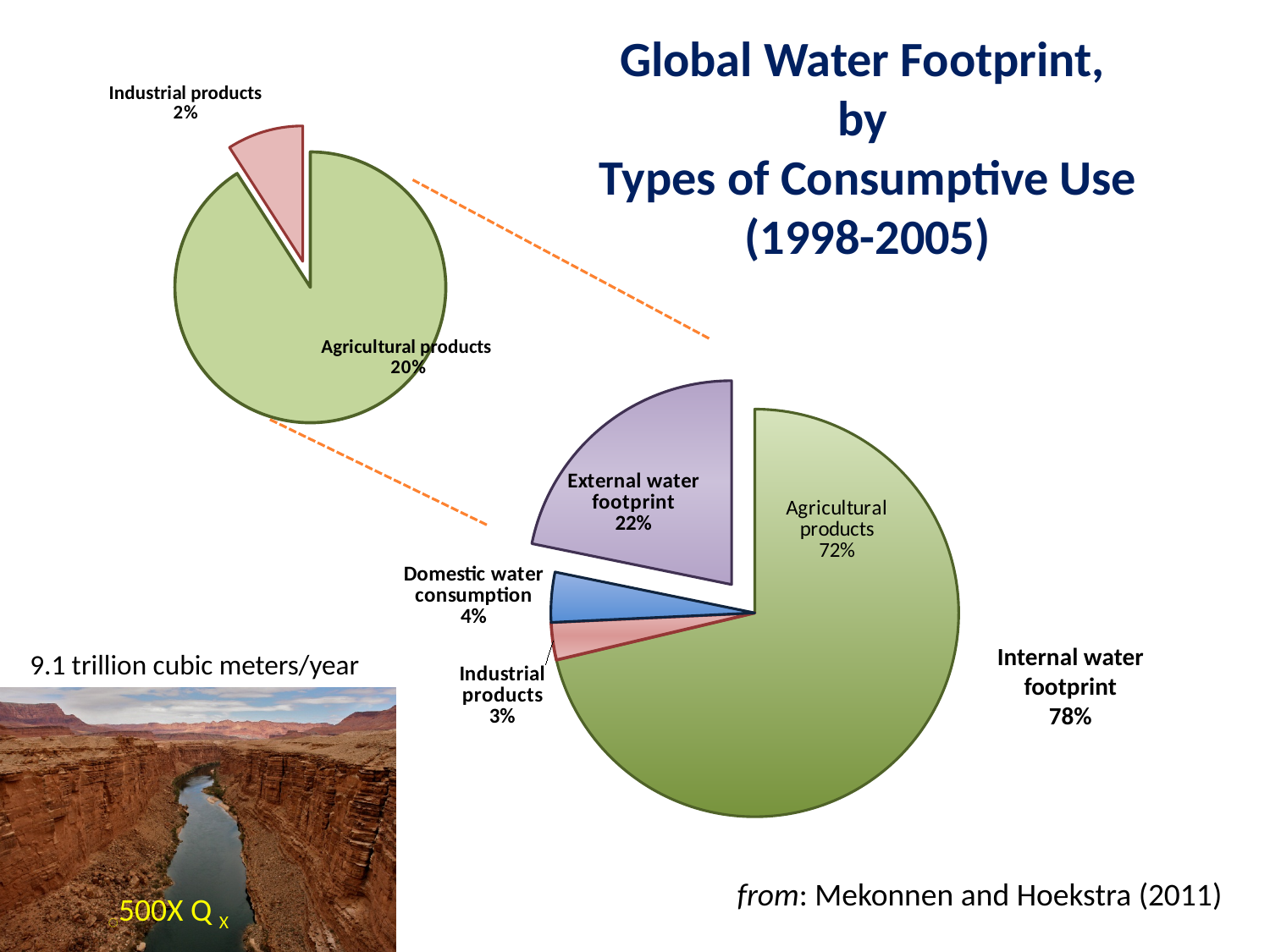
In the small pie chart at the upper left, what percentage is labelled for Agricultural products? 20% In the large pie chart, which labelled slice is the smallest? Industrial products In the large pie chart, what percentage is labelled for Agricultural products? 72% In the small pie chart at the upper left, what percentage is labelled for Industrial products? 2% In the large pie chart, which labelled slice is the largest? Agricultural products In the large pie chart, what percentage is labelled for Domestic water consumption? 4% In the large pie chart, what is the difference between the Agricultural products share and the External water footprint share? 50% What percentage is labelled for Internal water footprint on the slide? 78% In the large pie chart, which is larger: Domestic water consumption or Industrial products? Domestic water consumption What type of chart is used on this slide? Pie chart In the large pie chart, what percentage is labelled for Industrial products? 3% In the large pie chart, what percentage is labelled for External water footprint? 22%